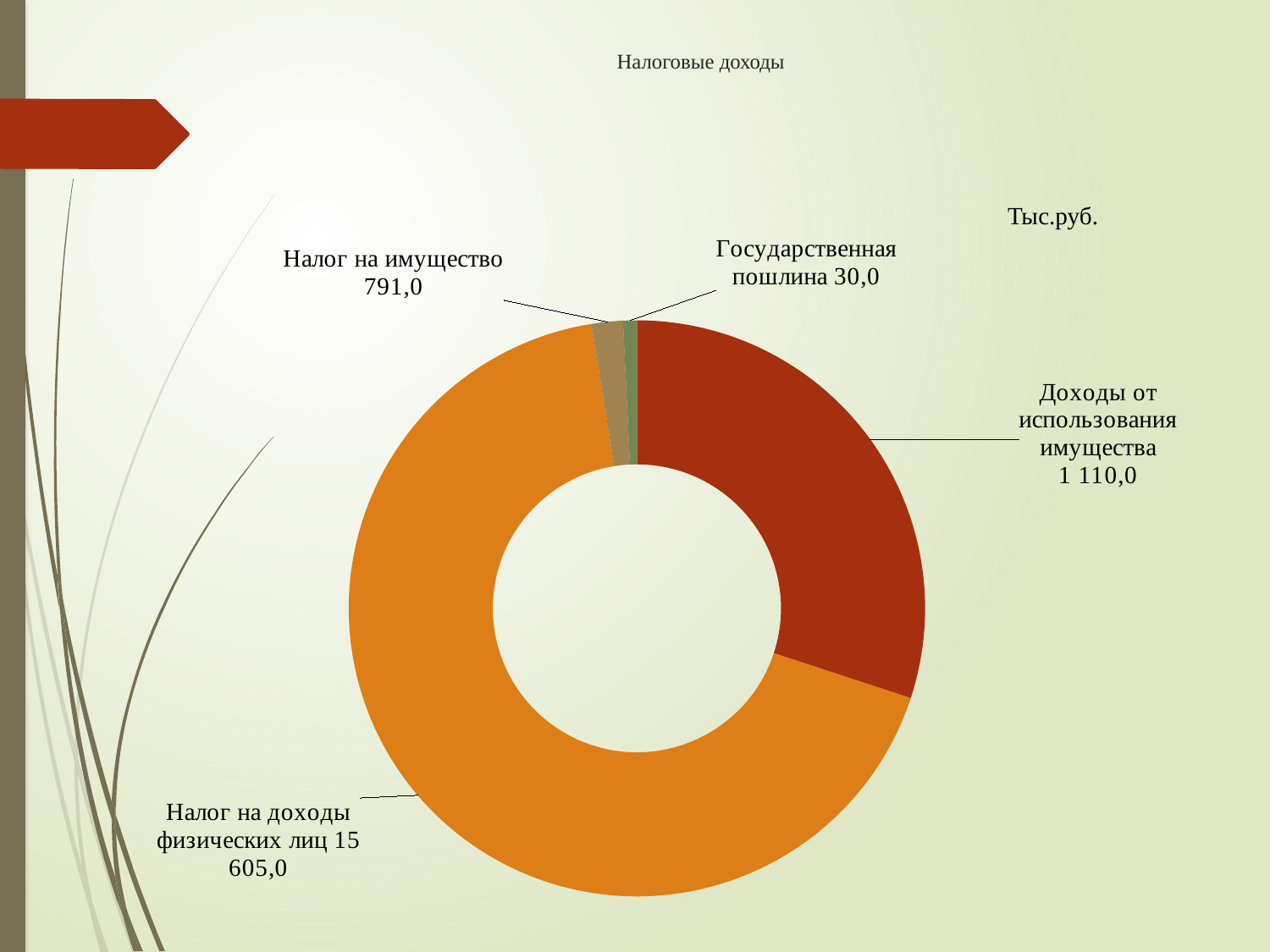
Which category has the largest value? Налог на доходы физических лиц What is the difference between Доходы от использования имущества and Налог на имущество? 319,0 What is the title of the chart? Налоговые доходы What is the value for Налог на имущество? 791,0 What is the value for Налог на доходы физических лиц? 15 605,0 What kind of chart is shown on the slide? doughnut chart What is the difference between Налог на имущество and Государственная пошлина? 761,0 Which is larger, Налог на имущество or Доходы от использования имущества? Доходы от использования имущества How many categories are shown in the chart? 4 What is the value for Государственная пошлина? 30,0 Which category has the smallest value? Государственная пошлина What is the value for Доходы от использования имущества? 1 110,0